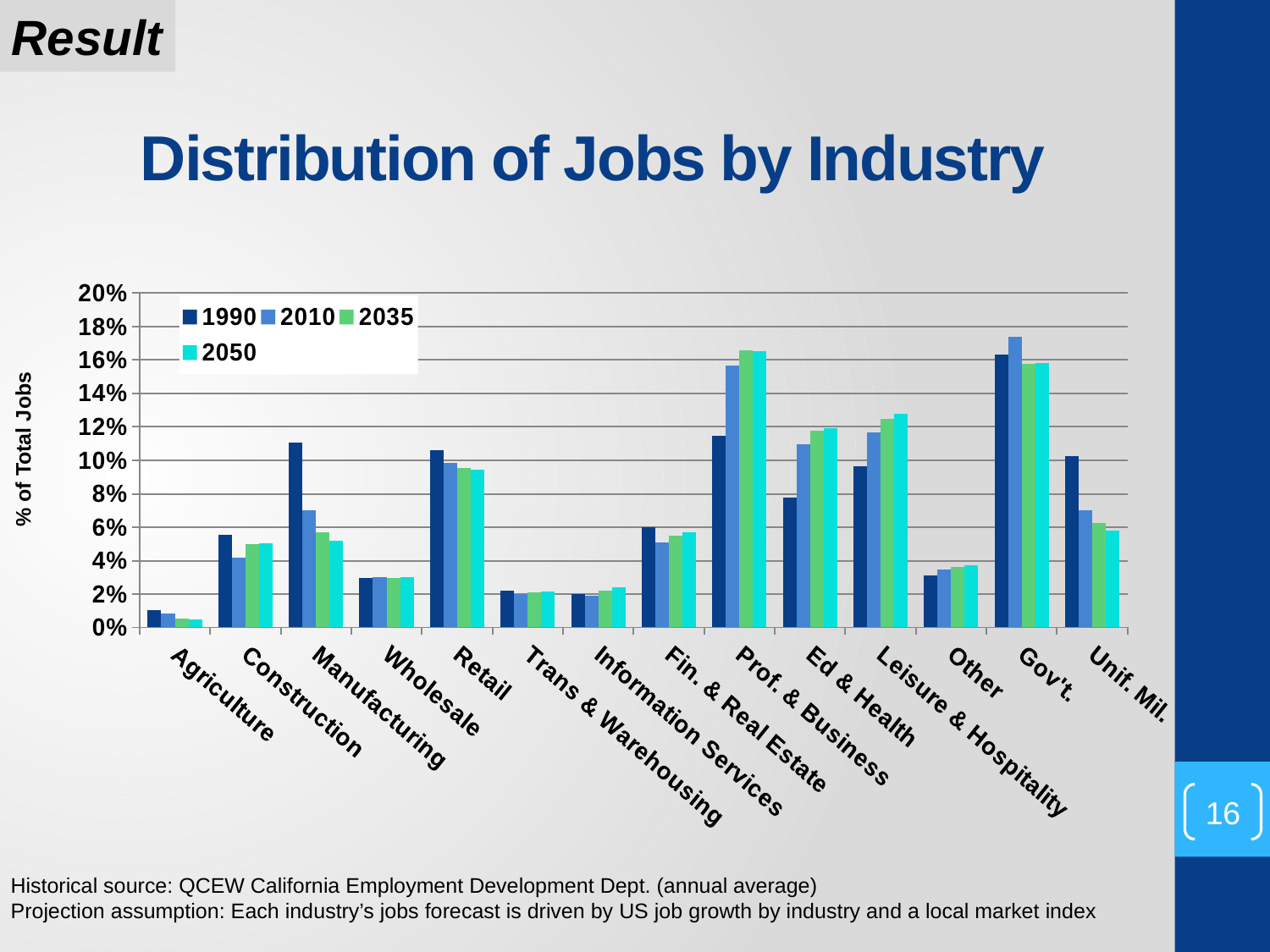
Is the 2010 value for Prof. & Business greater or less than 14%? greater What type of chart is shown on the slide? bar chart What is the title of the chart? Distribution of Jobs by Industry Which is larger in 2010: Gov't. or Prof. & Business? Gov't. Which industry has the lowest share of total jobs in 1990? Agriculture Is the 2050 value for Agriculture greater or less than 2%? less Which is larger in 1990: Manufacturing or Construction? Manufacturing How many industry categories are shown on the x axis? 14 Is the 1990 value for Manufacturing greater or less than 10%? greater Does the share of jobs in Manufacturing rise or fall from 1990 to 2050? fall How many series does the legend list? 4 Which industry has the highest share of total jobs in 1990? Gov't.